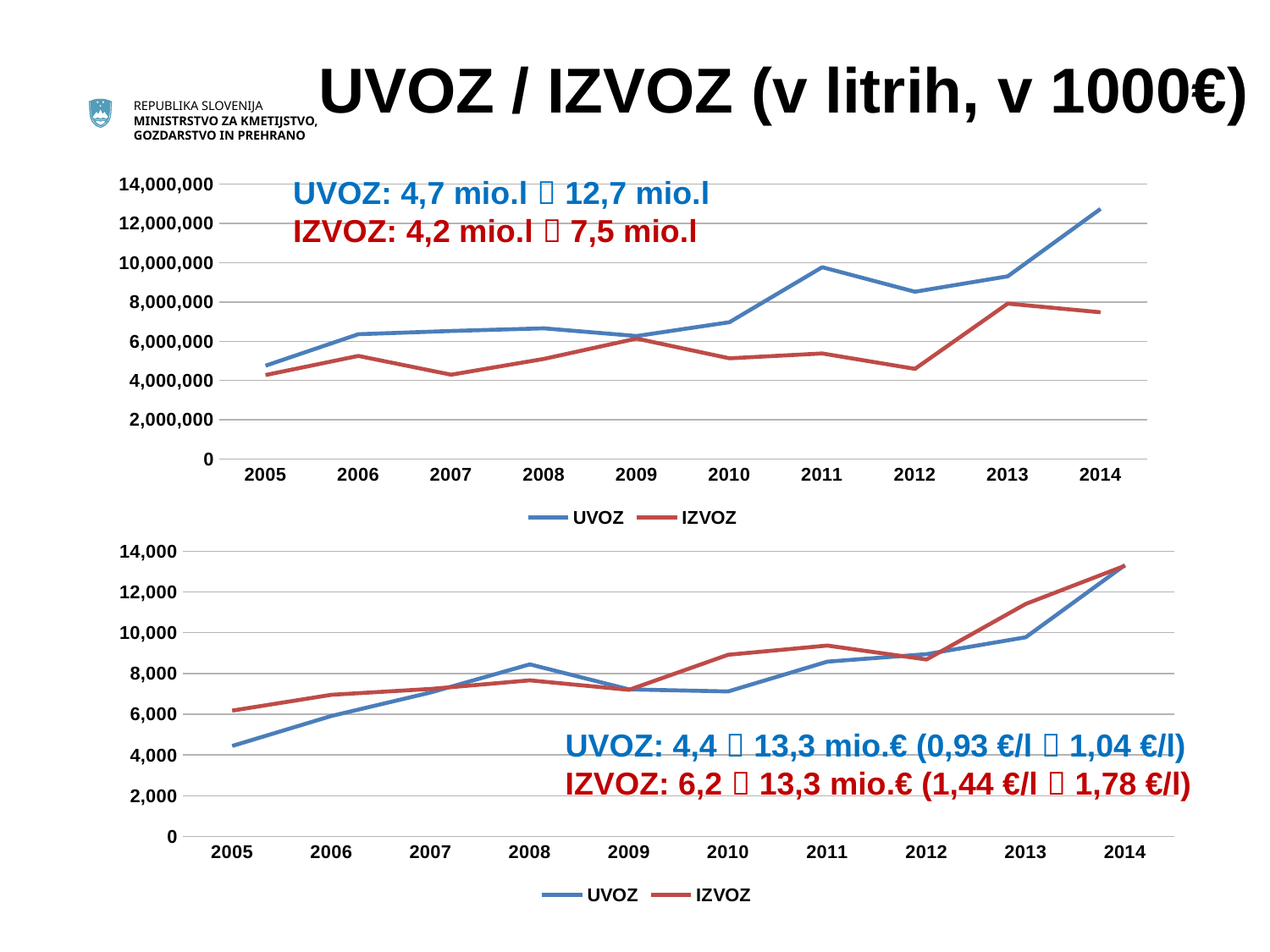
In the top chart (in litres), which series has the larger value in 2011, UVOZ or IZVOZ? UVOZ In the top chart (in litres), does the UVOZ series overall rise or fall from 2005 to 2014? rise In the bottom chart (in 1000€), which series has the larger value in 2005, UVOZ or IZVOZ? IZVOZ According to the annotation on the top chart, what was the UVOZ value in litres at the end of the period? 12,7 mio.l In the top chart (in litres), in which year is the UVOZ value highest? 2014 In the bottom chart (in 1000€), in which year is the UVOZ value lowest? 2005 In the top chart (in litres), is the UVOZ value for 2011 greater or less than 8,000,000? greater In the bottom chart (in 1000€), in which year is the IZVOZ value highest? 2014 How many series does the legend of the bottom chart (in 1000€) list? 2 How many years are shown on the x axis of the top chart (in litres)? 10 What kind of chart is the top chart (in litres)? line chart In the bottom chart (in 1000€), is the UVOZ value for 2005 greater or less than 6,000? less